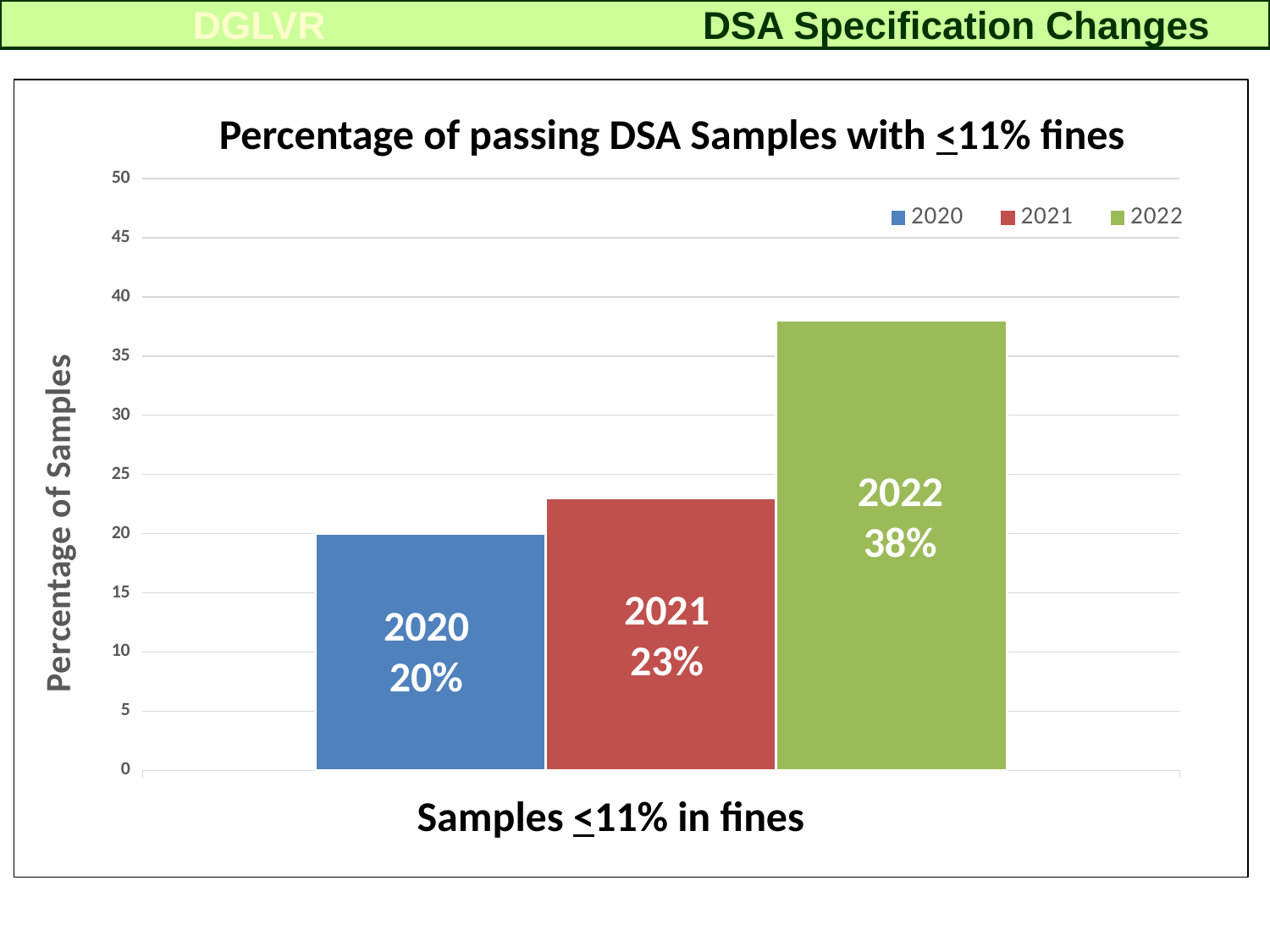
What kind of chart is shown on the slide? bar chart Which is larger, the value for 2021 or the value for 2020? 2021 How many series does the legend list? 3 Is the value for 2022 greater or less than 35? greater Do the values rise or fall from 2020 to 2022? rise Which year has the lowest percentage of passing DSA samples? 2020 What is the difference between the values for 2021 and 2020? 3% What is the value for 2021? 23% What is the difference between the values for 2022 and 2021? 15% What is the value for 2022? 38% What is the value for 2020? 20% Which year has the highest percentage of passing DSA samples? 2022